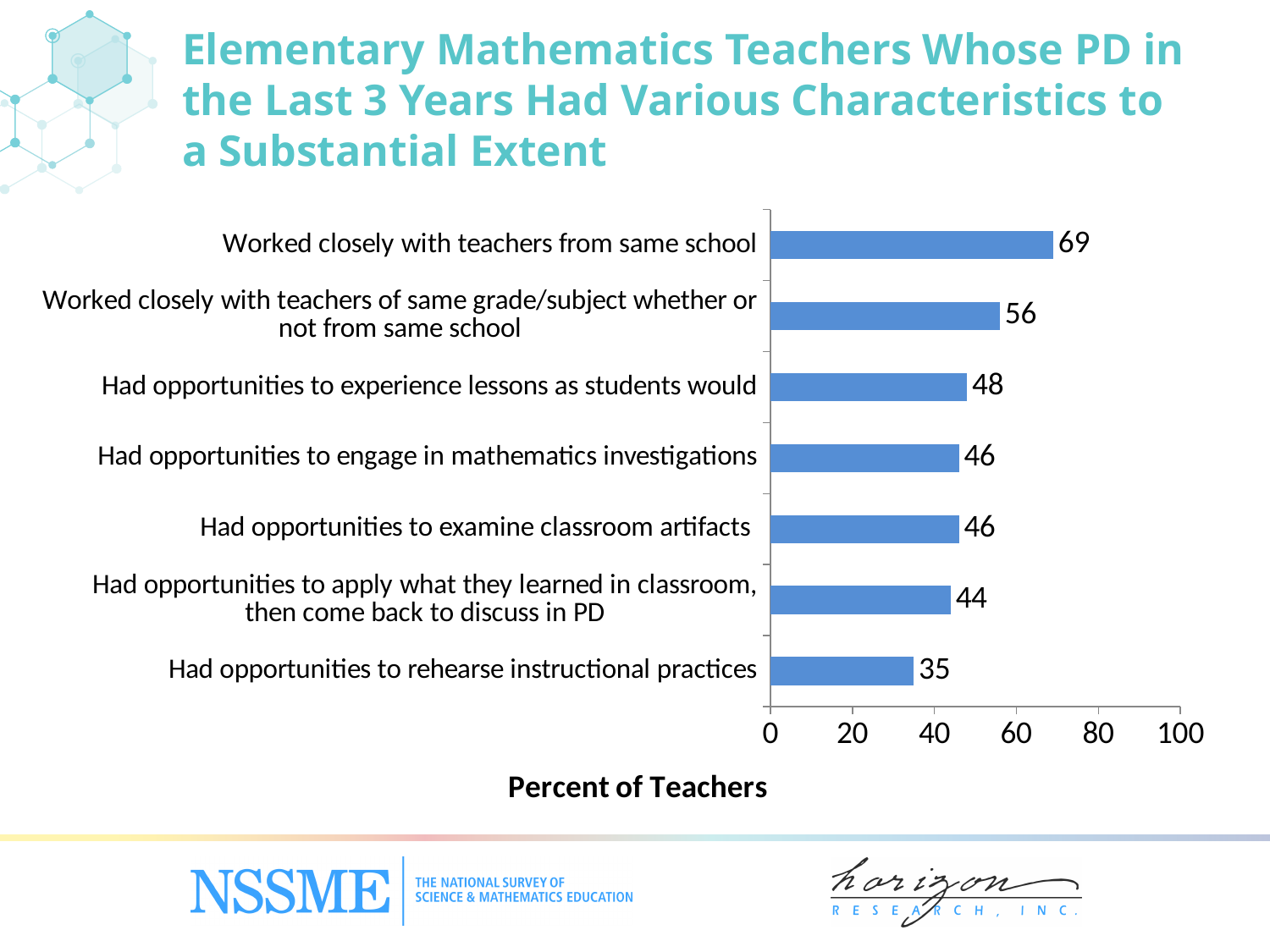
Which is larger: the value for 'Had opportunities to experience lessons as students would' or the value for 'Had opportunities to apply what they learned in classroom, then come back to discuss in PD'? Had opportunities to experience lessons as students would What kind of chart is shown on the slide? Bar chart Is the value for 'Had opportunities to rehearse instructional practices' greater or less than 40? less What is the value for 'Had opportunities to experience lessons as students would'? 48 Which characteristic has the lowest percent of teachers? Had opportunities to rehearse instructional practices What is the difference between the values for 'Had opportunities to engage in mathematics investigations' and 'Had opportunities to rehearse instructional practices'? 11 What is the difference between 'Worked closely with teachers from same school' and 'Worked closely with teachers of same grade/subject whether or not from same school'? 13 What percent of teachers worked closely with teachers from the same school? 69 How many characteristics are shown in the chart? 7 What is the label of the horizontal axis? Percent of Teachers What is the value for 'Had opportunities to rehearse instructional practices'? 35 Which characteristic has the highest percent of teachers? Worked closely with teachers from same school